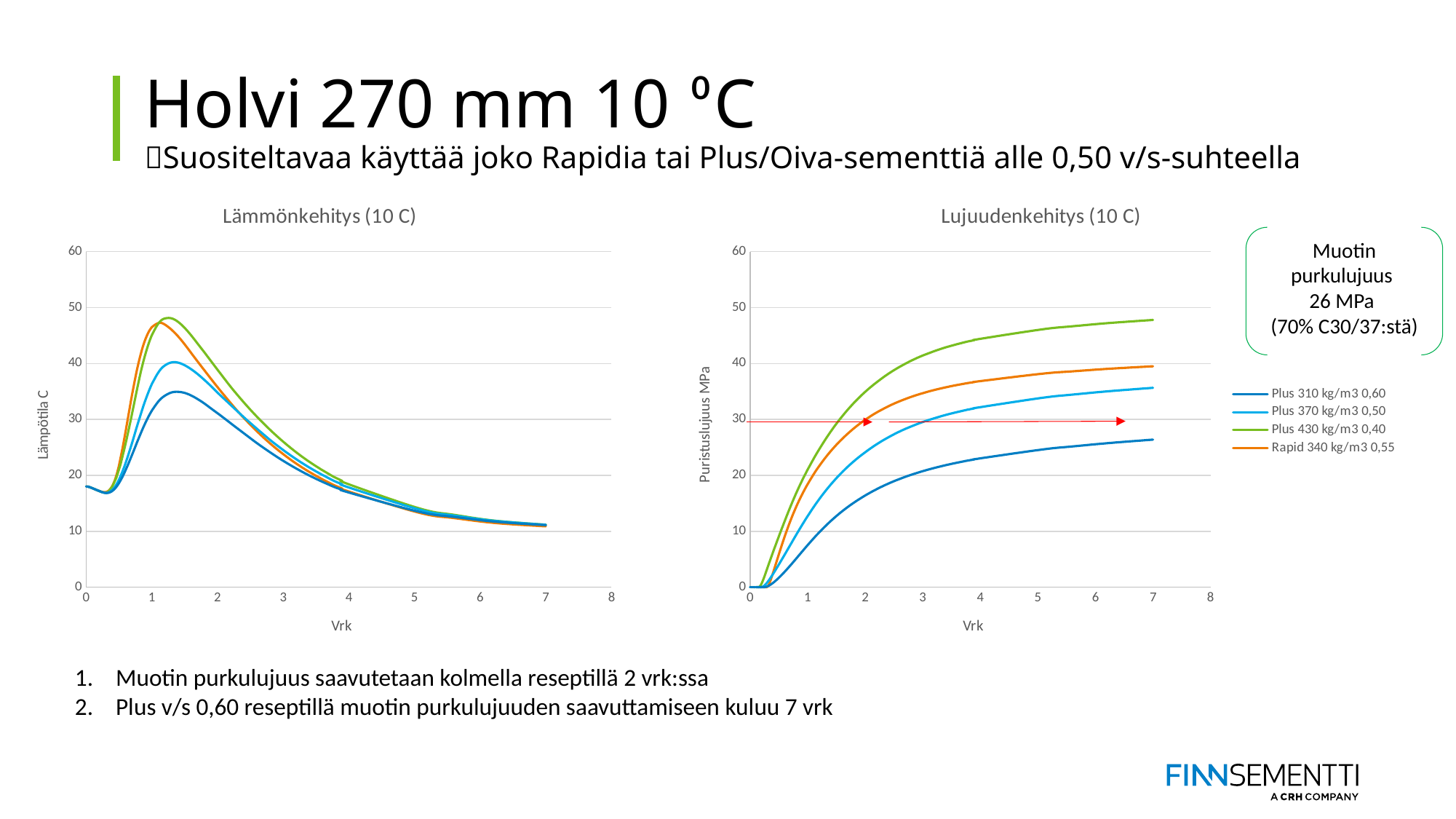
In the left chart "Lämmönkehitys (10 C)", which is larger at day 1: the value for Plus 430 kg/m3 0,40 or the value for Plus 310 kg/m3 0,60? Plus 430 kg/m3 0,40 How many series does the legend list for the charts? 4 In the left chart "Lämmönkehitys (10 C)", which series reaches the highest peak temperature? Plus 430 kg/m3 0,40 In the right chart "Lujuudenkehitys (10 C)", is the value for Plus 430 kg/m3 0,40 at day 7 greater or less than 40? greater In the left chart "Lämmönkehitys (10 C)", is the peak value for Plus 310 kg/m3 0,60 greater or less than 40? less In the right chart "Lujuudenkehitys (10 C)", which series has the lowest value at day 7? Plus 310 kg/m3 0,60 In the right chart "Lujuudenkehitys (10 C)", do the values rise or fall as the days increase along the x axis? rise What kind of chart is the left chart titled "Lämmönkehitys (10 C)"? line chart What is the y-axis title of the right chart "Lujuudenkehitys (10 C)"? Puristuslujuus MPa In the right chart "Lujuudenkehitys (10 C)", is the value for Plus 310 kg/m3 0,60 at day 7 greater or less than 30? less In the left chart "Lämmönkehitys (10 C)", do the values rise or fall between day 2 and day 7? fall In the right chart "Lujuudenkehitys (10 C)", which series reaches the highest value at day 7? Plus 430 kg/m3 0,40